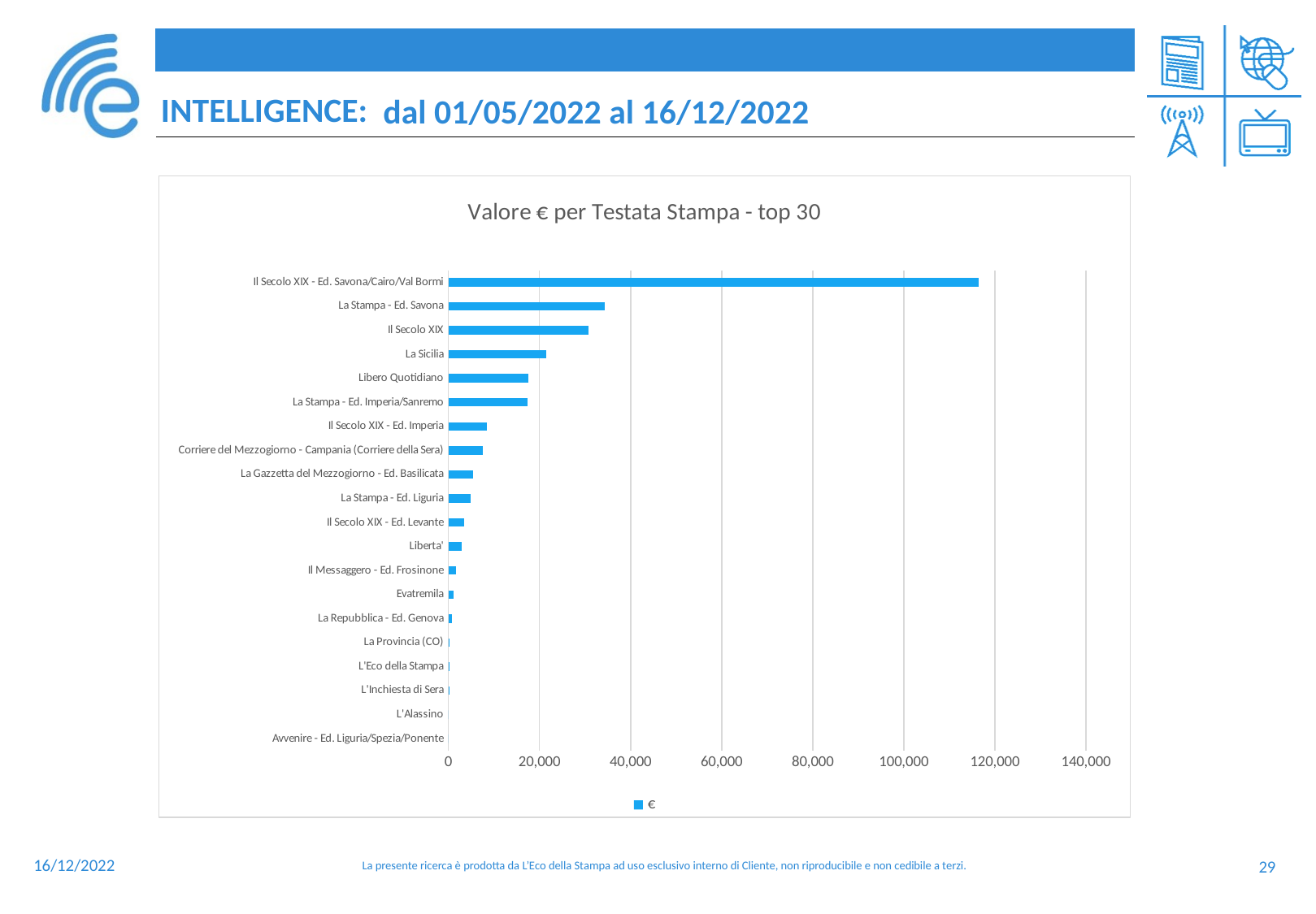
Is the value for Il Secolo XIX - Ed. Savona/Cairo/Val Bormi greater or less than 100,000? greater How many categories (testate) are plotted on the chart? 20 What is the title of the chart? Valore € per Testata Stampa - top 30 Do the values rise or fall going from the top category to the bottom category? fall Is the value for Libero Quotidiano greater or less than 20,000? less What kind of chart is shown on the slide? bar chart What is the legend entry for the series? € Is the value for Il Secolo XIX - Ed. Imperia greater or less than 20,000? less Which has the larger value, La Stampa - Ed. Savona or La Sicilia? La Stampa - Ed. Savona How many series does the legend list? 1 Which testata has the highest value? Il Secolo XIX - Ed. Savona/Cairo/Val Bormi